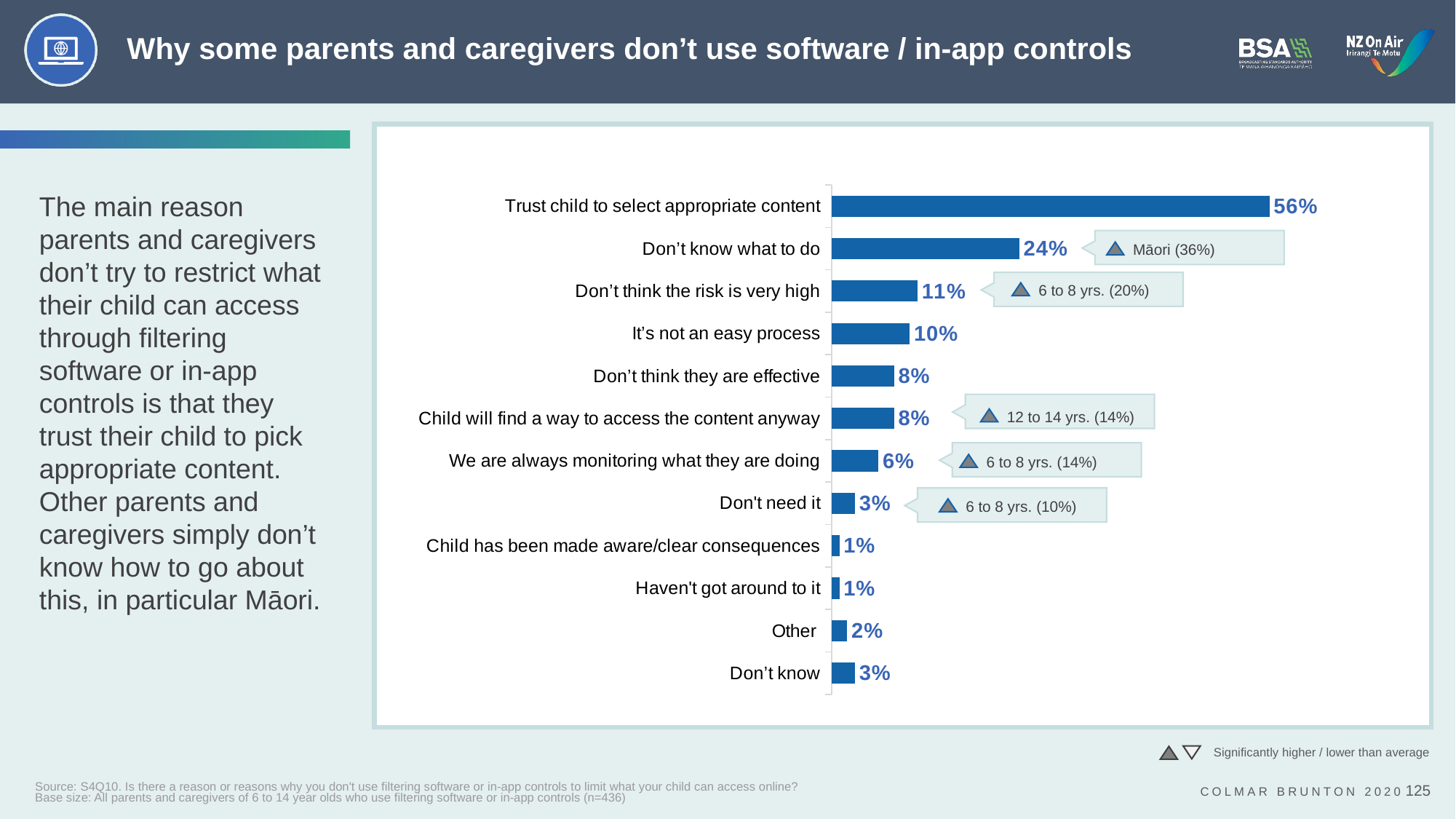
How many reason categories are shown in the chart? 12 What is the value for 'We are always monitoring what they are doing'? 6% What type of chart is shown on the slide? Bar chart What percentage of Māori parents and caregivers say they don't know what to do, according to the callout? 36% What is the difference between 'Don't think the risk is very high' and 'Don't need it'? 8% Which is larger, 'Don't think the risk is very high' or 'Don't think they are effective'? Don't think the risk is very high What is the value for 'It's not an easy process'? 10% Which reason has the highest percentage? Trust child to select appropriate content According to the callout, what percentage of parents of 6 to 8 year olds say they don't think the risk is very high? 20% What is the value for 'Don't know what to do'? 24% What percentage of parents and caregivers say they trust their child to select appropriate content? 56% What is the difference between 'Trust child to select appropriate content' and 'Don't know what to do'? 32%